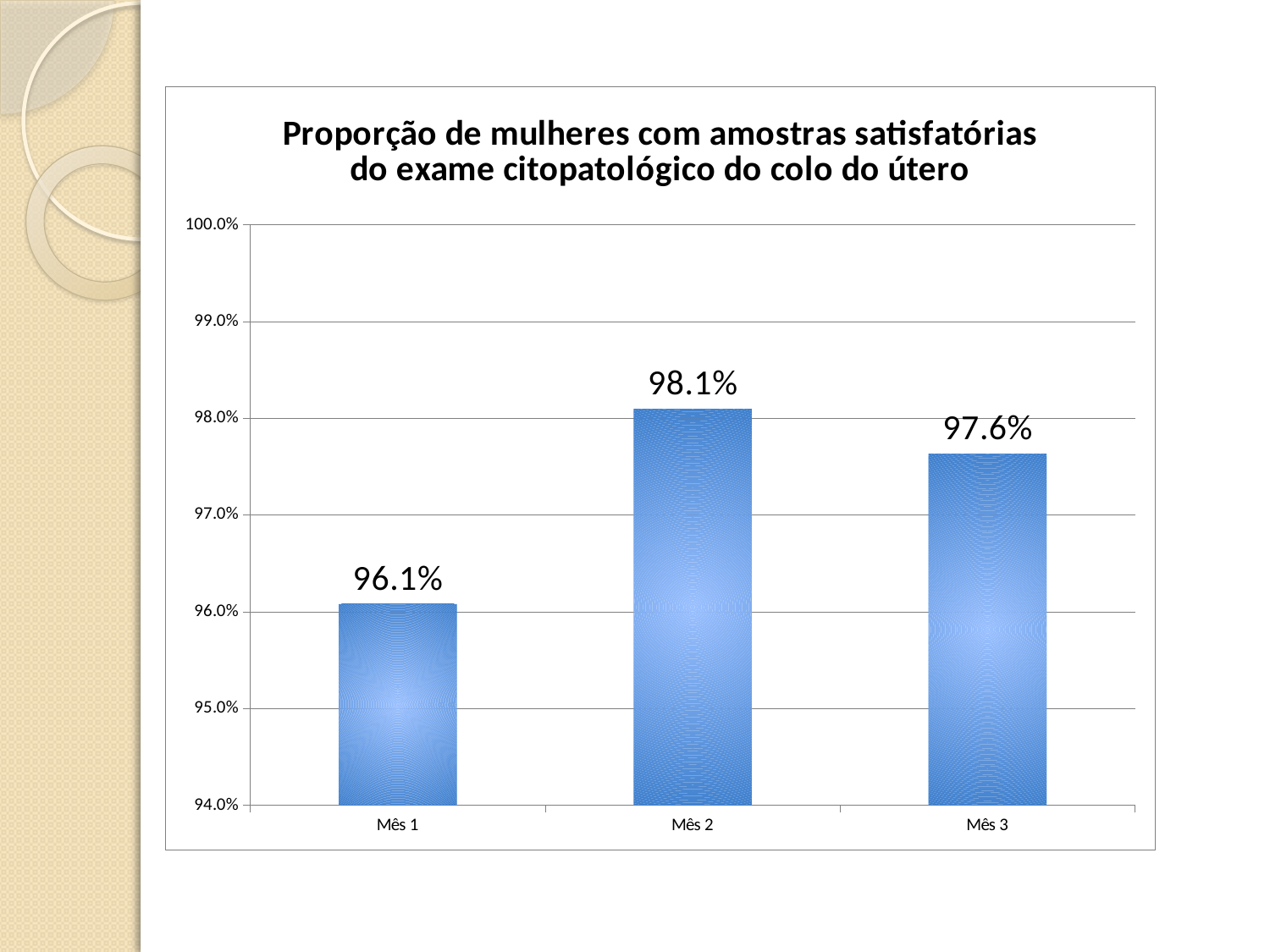
Which month has the lowest value? Mês 1 What is the value for Mês 3? 97.6% What kind of chart is shown on the slide? bar chart Is the value for Mês 1 greater or less than 97.0%? less What is the difference between the values for Mês 2 and Mês 1? 2.0% How many months are shown on the chart? 3 What is the value for Mês 2? 98.1% Which is larger, the value for Mês 3 or the value for Mês 1? Mês 3 What is the difference between the values for Mês 2 and Mês 3? 0.5% What is the value for Mês 1? 96.1% Which month has the highest value? Mês 2 What is the title of the chart? Proporção de mulheres com amostras satisfatórias do exame citopatológico do colo do útero